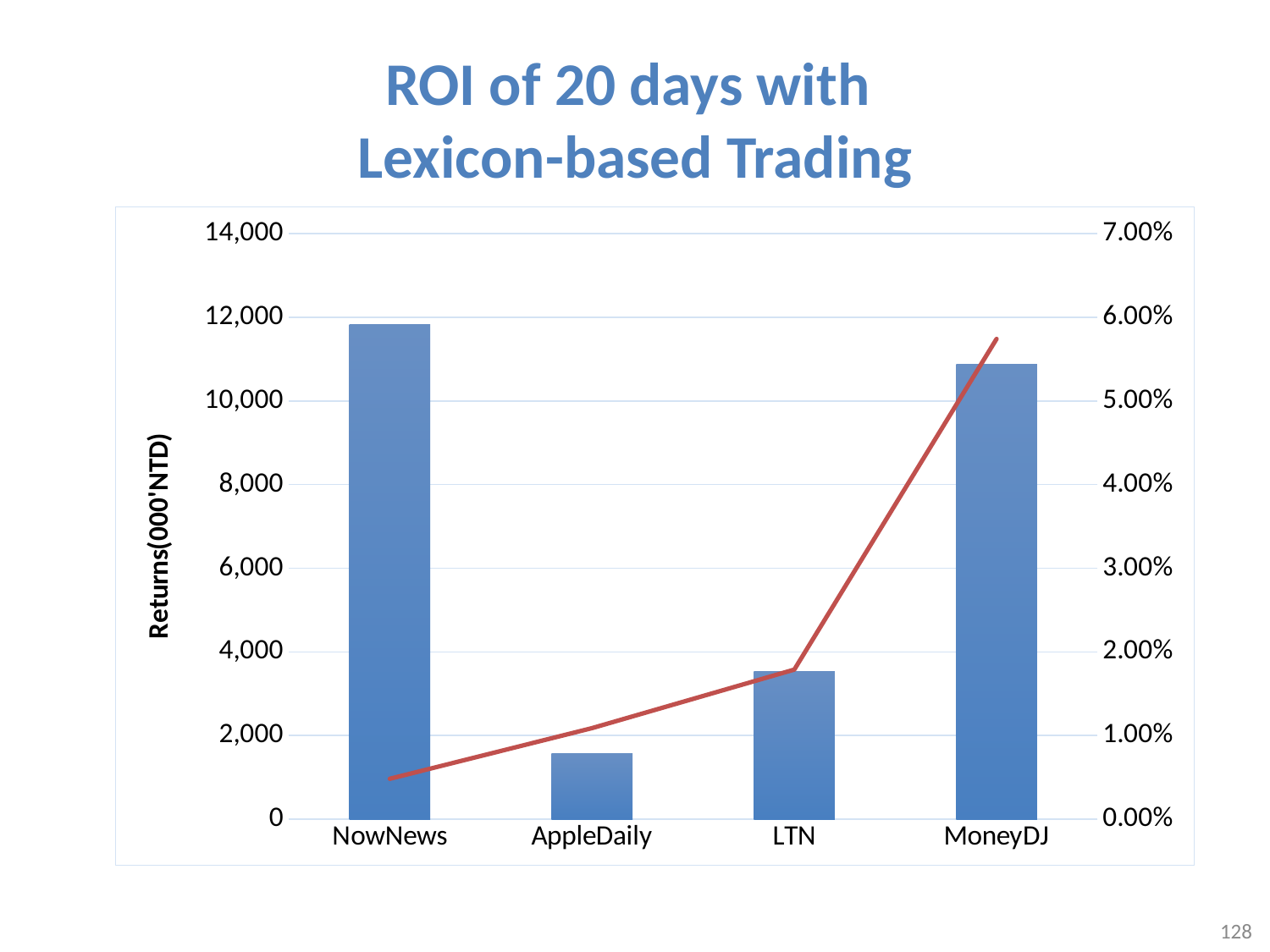
What is the label of the left vertical axis? Returns(000'NTD) Which category has the shortest bar? AppleDaily What is the title of the chart? ROI of 20 days with Lexicon-based Trading Which has a taller bar, NowNews or MoneyDJ? NowNews Is the line value for MoneyDJ on the right axis greater or less than 5.00%? greater Is the bar value for NowNews greater or less than 10,000? greater Is the bar value for LTN greater or less than 4,000? less How many categories are shown on the x axis? 4 Does the red line rise or fall from NowNews to MoneyDJ? rises Which category has the tallest bar? NowNews Which has a taller bar, LTN or MoneyDJ? MoneyDJ